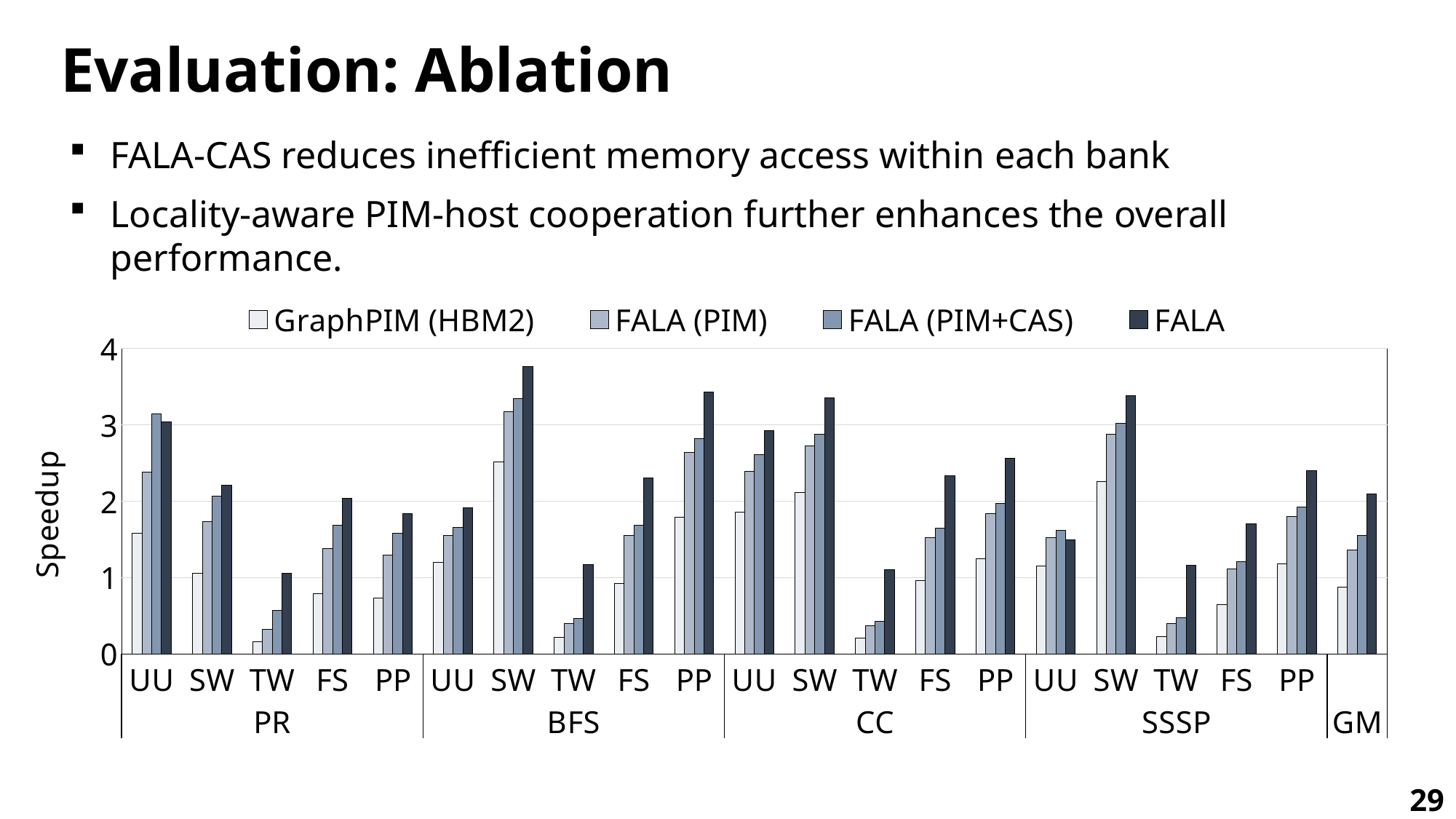
What type of chart is shown on the slide? bar chart How many series does the legend list? 4 Is the GraphPIM (HBM2) value for GM greater or less than 1? less Which input graph in the PR group has the lowest GraphPIM (HBM2) bar? TW Which is larger: the FALA value for SW in the BFS group or the FALA value for SW in the CC group? SW in the BFS group What is the first entry in the chart's legend? GraphPIM (HBM2) Is the FALA value for GM greater or less than 2? greater What is the label on the y axis of the chart? Speedup Is the GraphPIM (HBM2) value for SW in the BFS group greater or less than 2? greater Which input graph in the BFS group has the highest FALA bar? SW How many input graphs are listed under the PR group on the x axis? 5